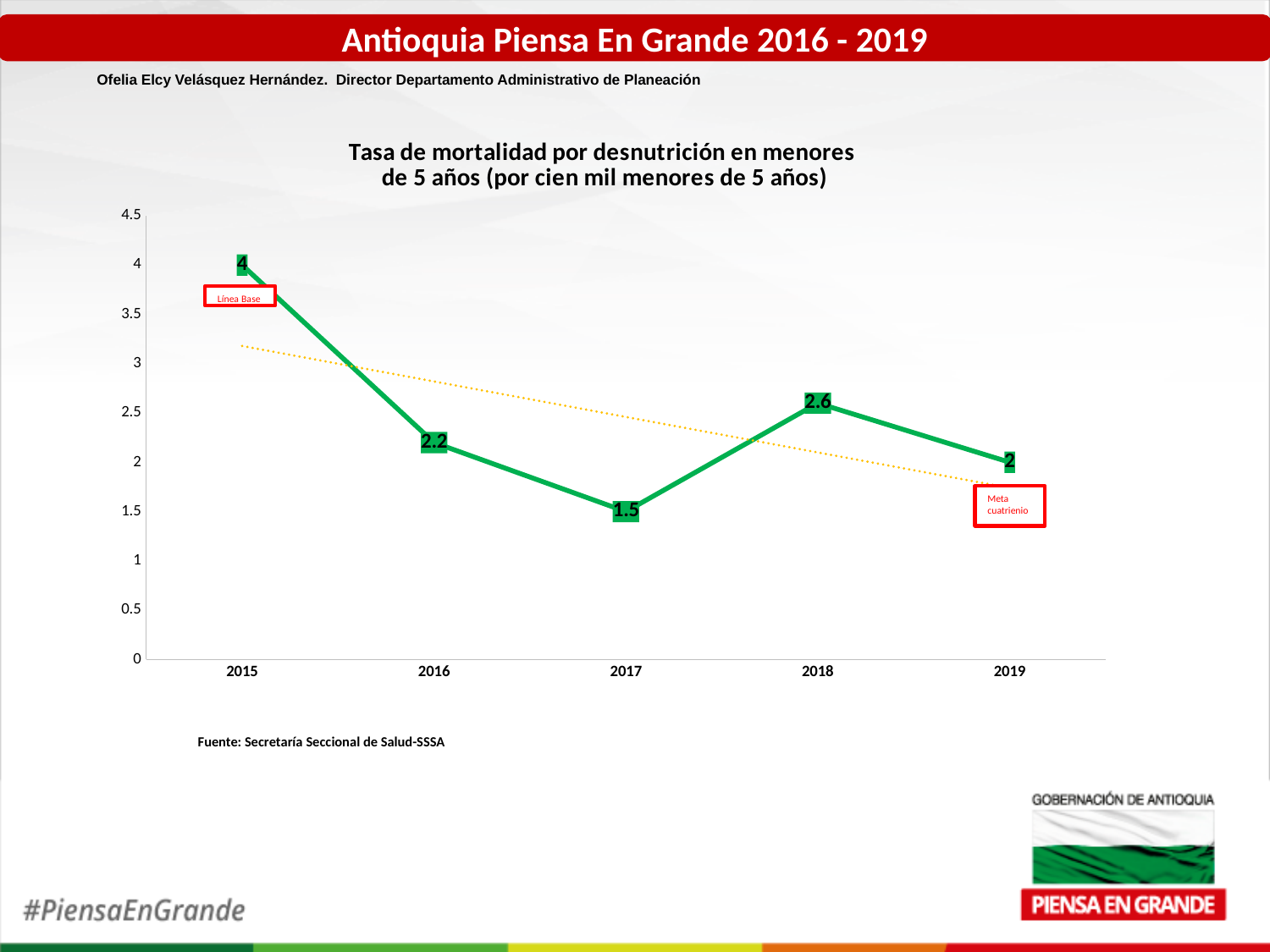
What kind of chart is shown? line chart Which is larger, the value for 2016 or the value for 2018? 2018 What is the difference between the values for 2015 and 2016? 1.8 Is the value for 2016 greater or less than 3? less Which year has the lowest value? 2017 What is the title of the chart? Tasa de mortalidad por desnutrición en menores de 5 años (por cien mil menores de 5 años) What is the value for 2019? 2 Which year has the highest value? 2015 What is the value for 2015? 4 How many years are plotted on the x axis? 5 What is the value for 2017? 1.5 What is the value for 2018? 2.6